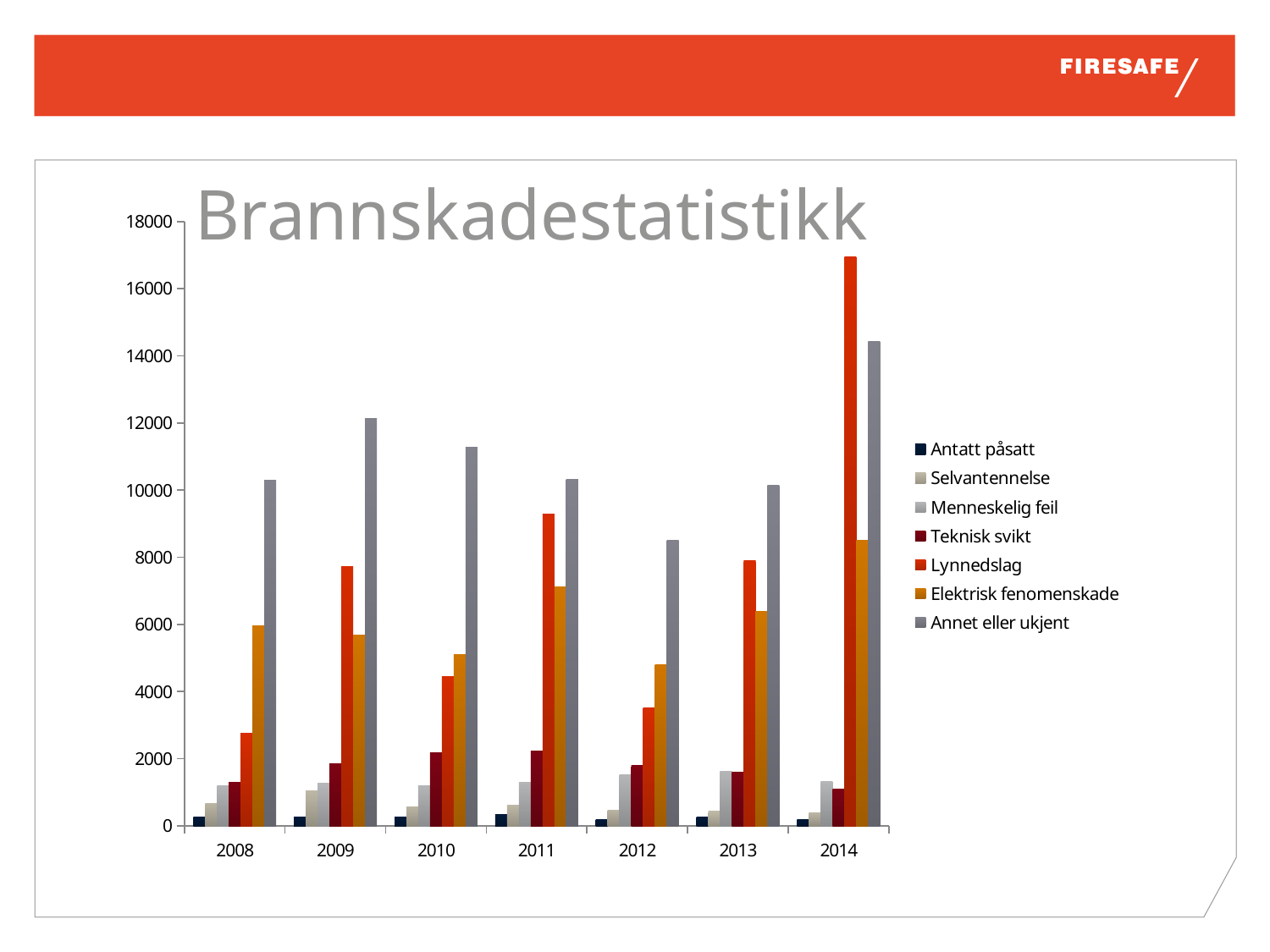
In which year is the value for Annet eller ukjent lowest? 2012 How many series does the legend list? 7 How many years are shown on the x axis? 7 Is the value for Lynnedslag in 2014 greater or less than 16000? greater Is the value for Elektrisk fenomenskade in 2010 greater or less than 6000? less In which year is the value for Lynnedslag highest? 2014 What kind of chart is shown on the slide? Bar chart What is the title of the chart? Brannskadestatistikk Does the value for Lynnedslag rise or fall from 2012 to 2014? rise In 2008, which is larger: Lynnedslag or Elektrisk fenomenskade? Elektrisk fenomenskade In 2011, which is larger: Lynnedslag or Elektrisk fenomenskade? Lynnedslag In which year is the value for Annet eller ukjent highest? 2014